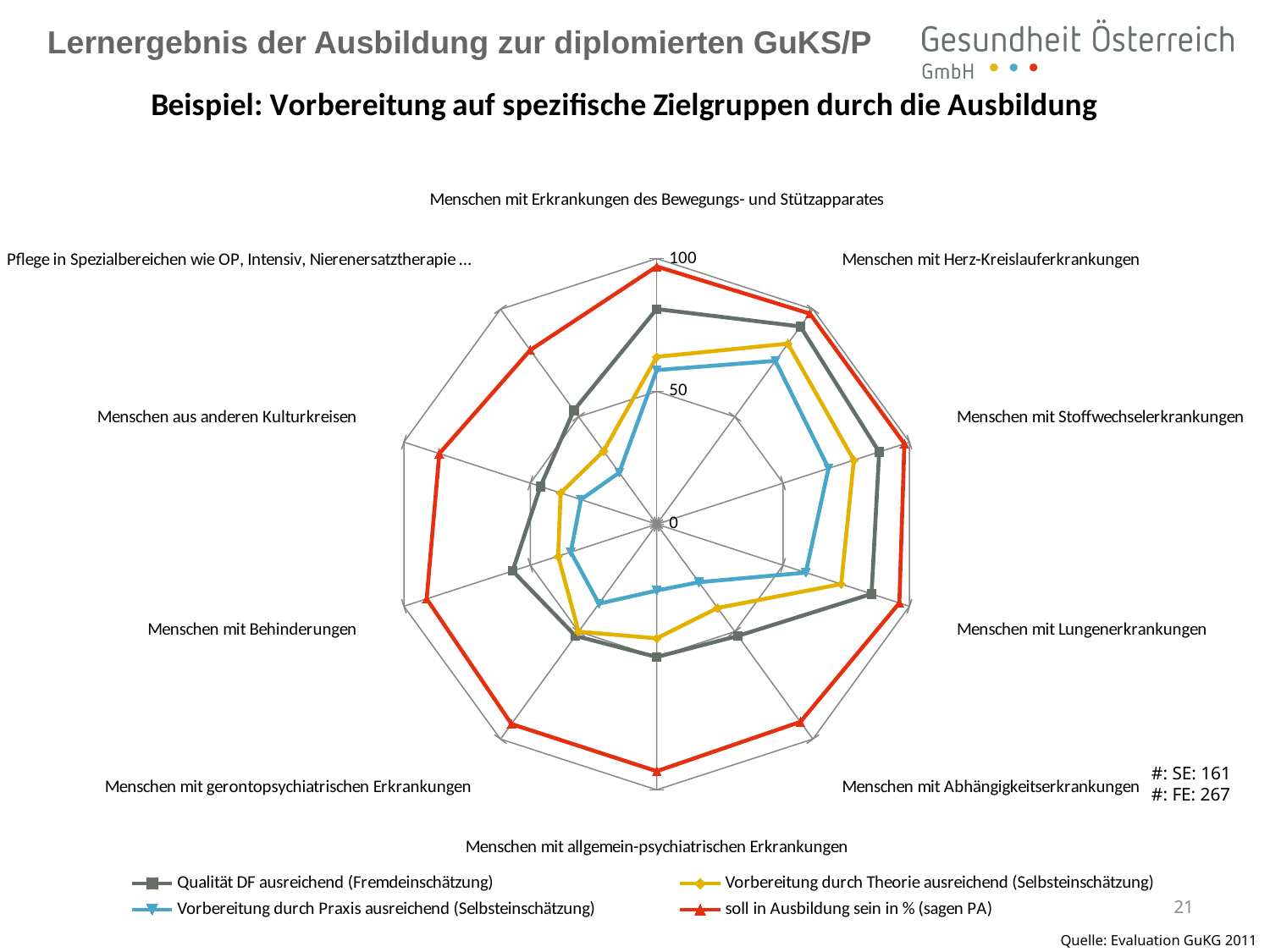
How many categories (axes) does the radar chart have? 10 How many series does the legend list? 4 What colour is the line for 'soll in Ausbildung sein in % (sagen PA)'? Red Is the value of 'soll in Ausbildung sein in % (sagen PA)' for 'Menschen mit Erkrankungen des Bewegungs- und Stützapparates' greater or less than 50? greater Which series has the lowest value for 'Menschen mit Behinderungen'? Vorbereitung durch Praxis ausreichend (Selbsteinschätzung) For 'Menschen mit Erkrankungen des Bewegungs- und Stützapparates', which is larger: 'soll in Ausbildung sein in % (sagen PA)' or 'Vorbereitung durch Praxis ausreichend (Selbsteinschätzung)'? soll in Ausbildung sein in % (sagen PA) Is the value of 'Vorbereitung durch Praxis ausreichend (Selbsteinschätzung)' for 'Menschen mit Abhängigkeitserkrankungen' greater or less than 50? less Is the value of 'Vorbereitung durch Praxis ausreichend (Selbsteinschätzung)' for 'Menschen aus anderen Kulturkreisen' greater or less than 50? less What kind of chart is shown on the slide? Radar chart Which series has the highest value for 'Menschen mit gerontopsychiatrischen Erkrankungen'? soll in Ausbildung sein in % (sagen PA)